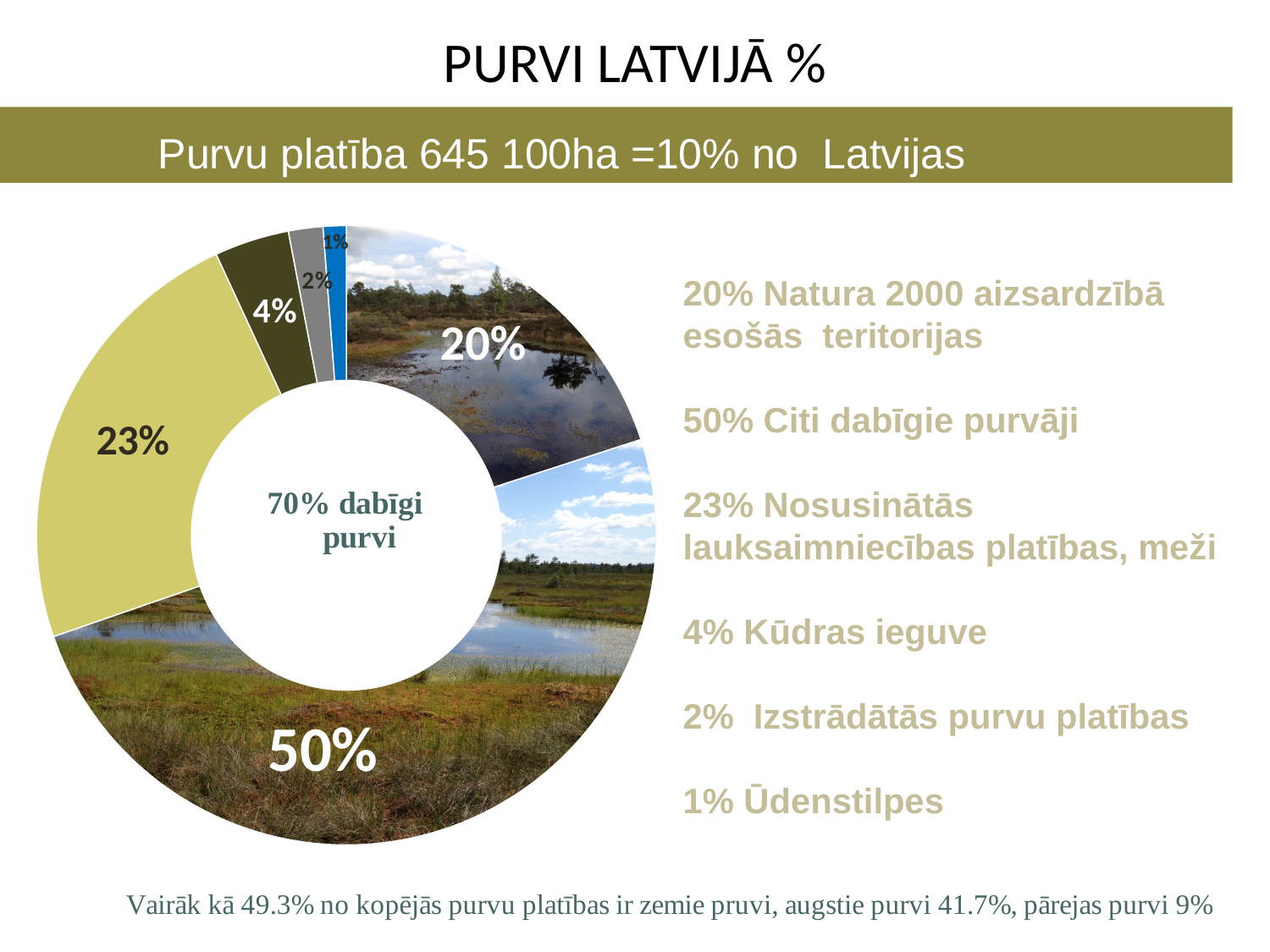
What percentage is shown for Kūdras ieguve? 4% What percentage of the chart is labelled for Citi dabīgie purvāji? 50% Which category has the largest slice in the chart? Citi dabīgie purvāji (50%) What percentage is shown for Ūdenstilpes? 1% What is the difference between the Citi dabīgie purvāji slice and the Nosusinātās lauksaimniecības platības, meži slice? 27% What text is written in the centre of the doughnut chart? 70% dabīgi purvi Which category has the smallest slice in the chart? Ūdenstilpes (1%) What kind of chart is shown on the slide? Doughnut (pie) chart Which is larger: the slice for Natura 2000 aizsardzībā esošās teritorijas or the slice for Nosusinātās lauksaimniecības platības, meži? Nosusinātās lauksaimniecības platības, meži How many slices does the doughnut chart have? 6 What share does Natura 2000 aizsardzībā esošās teritorijas have in the chart? 20% What percentage is shown for Nosusinātās lauksaimniecības platības, meži? 23%